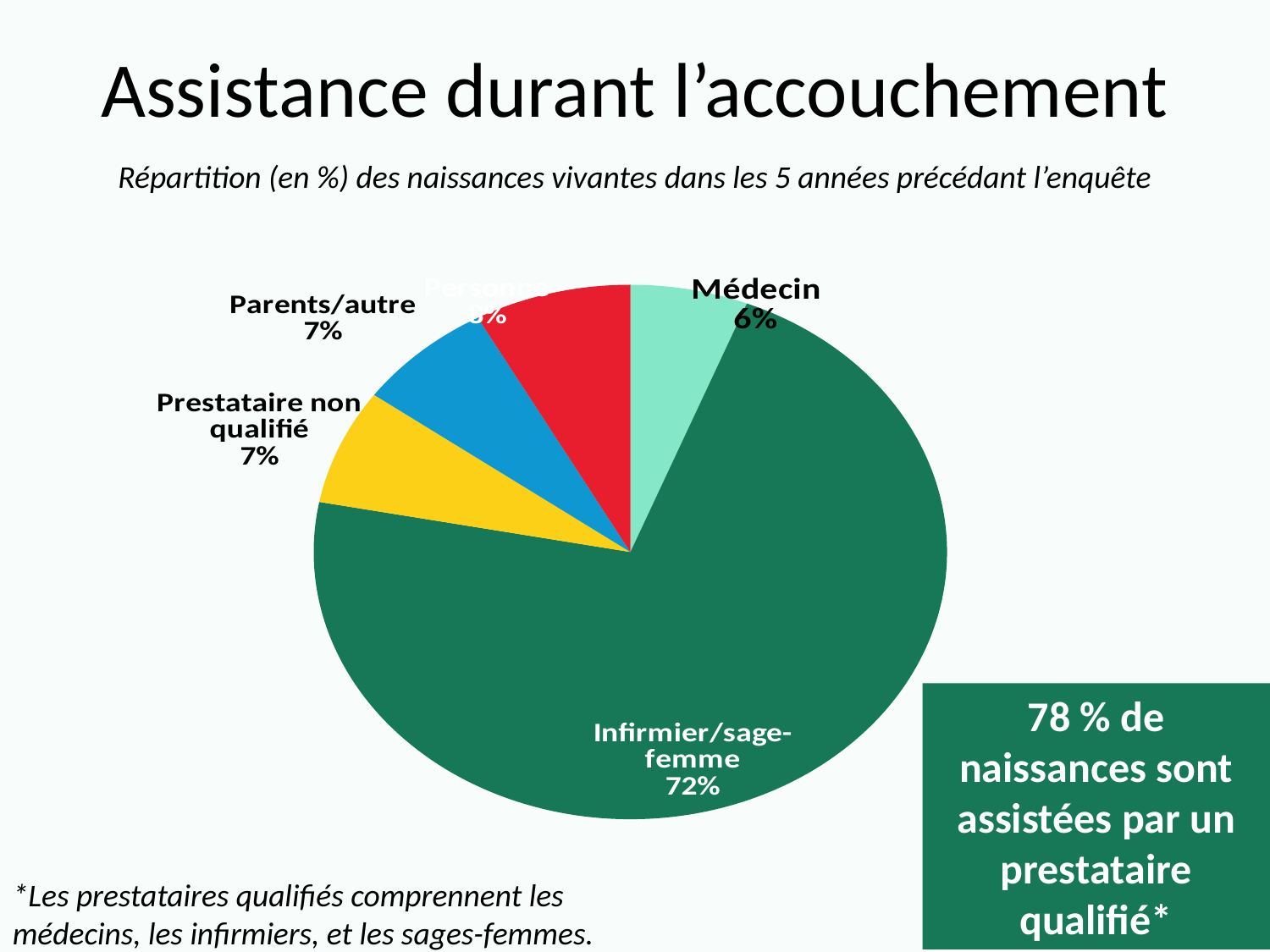
Which is larger, the share for Médecin or the share for Parents/autre? Parents/autre What kind of chart is shown on the slide? Pie chart What percentage of live births were assisted by an Infirmier/sage-femme? 72% What percentage of live births were assisted by a Médecin? 6% Which category has the largest share of the pie? Infirmier/sage-femme What is the value shown for the Prestataire non qualifié slice? 7% How many slices does the pie chart have? 5 What is the title of the slide? Assistance durant l'accouchement Which labelled category has the smallest share of the pie? Médecin What is the value shown for the Parents/autre slice? 7% According to the slide, what percentage of births are assisted by a qualified provider? 78 % How many percentage points larger is the Infirmier/sage-femme share than the Médecin share? 66 percentage points